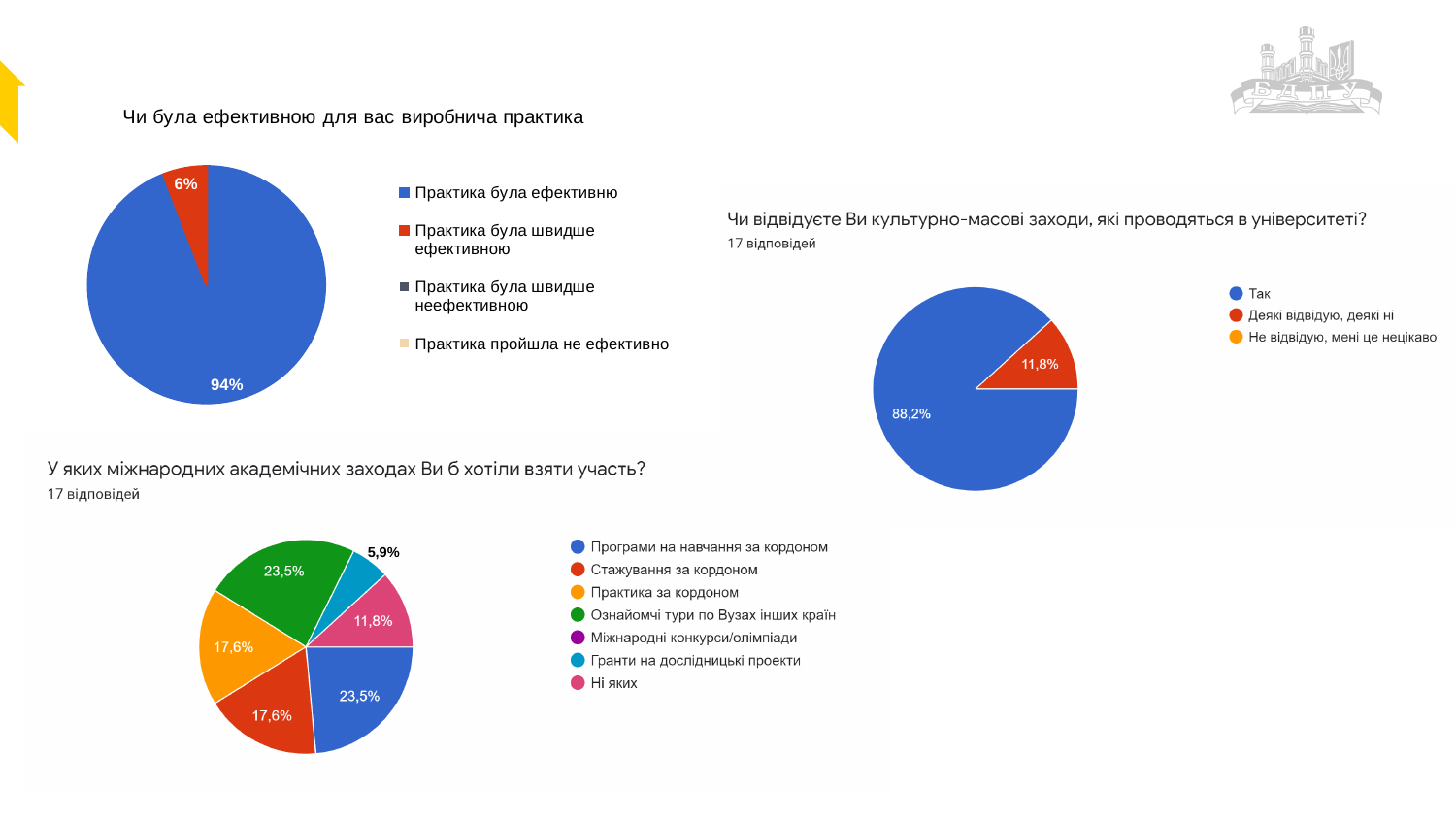
In the chart titled "Чи була ефективною для вас виробнича практика", how many entries does the legend list? 4 In the chart titled "Чи відвідуєте Ви культурно-масові заходи, які проводяться в університеті?", what share is labelled for "Деякі відвідую, деякі ні"? 11,8% In the chart titled "У яких міжнародних академічних заходах Ви б хотіли взяти участь?", which is larger: the share for "Ознайомчі тури по Вузах інших країн" or the share for "Стажування за кордоном"? Ознайомчі тури по Вузах інших країн In the chart titled "Чи була ефективною для вас виробнича практика", what share is labelled for "Практика була швидше ефективною"? 6% In the chart titled "У яких міжнародних академічних заходах Ви б хотіли взяти участь?", how many entries does the legend list? 7 In the chart titled "Чи відвідуєте Ви культурно-масові заходи, які проводяться в університеті?", what share is labelled for "Так"? 88,2% In the chart titled "Чи була ефективною для вас виробнича практика", what share is labelled for "Практика була ефективню"? 94% In the chart titled "Чи відвідуєте Ви культурно-масові заходи, які проводяться в університеті?", what is the difference between the shares for "Так" and "Деякі відвідую, деякі ні"? 76,4% What kind of chart is the one titled "Чи відвідуєте Ви культурно-масові заходи, які проводяться в університеті?"? Pie chart In the chart titled "У яких міжнародних академічних заходах Ви б хотіли взяти участь?", what share is labelled for "Ні яких"? 11,8% In the chart titled "У яких міжнародних академічних заходах Ви б хотіли взяти участь?", which labelled slice has the smallest share? Гранти на дослідницькі проекти In the chart titled "У яких міжнародних академічних заходах Ви б хотіли взяти участь?", what share is labelled for "Програми на навчання за кордоном"? 23,5%